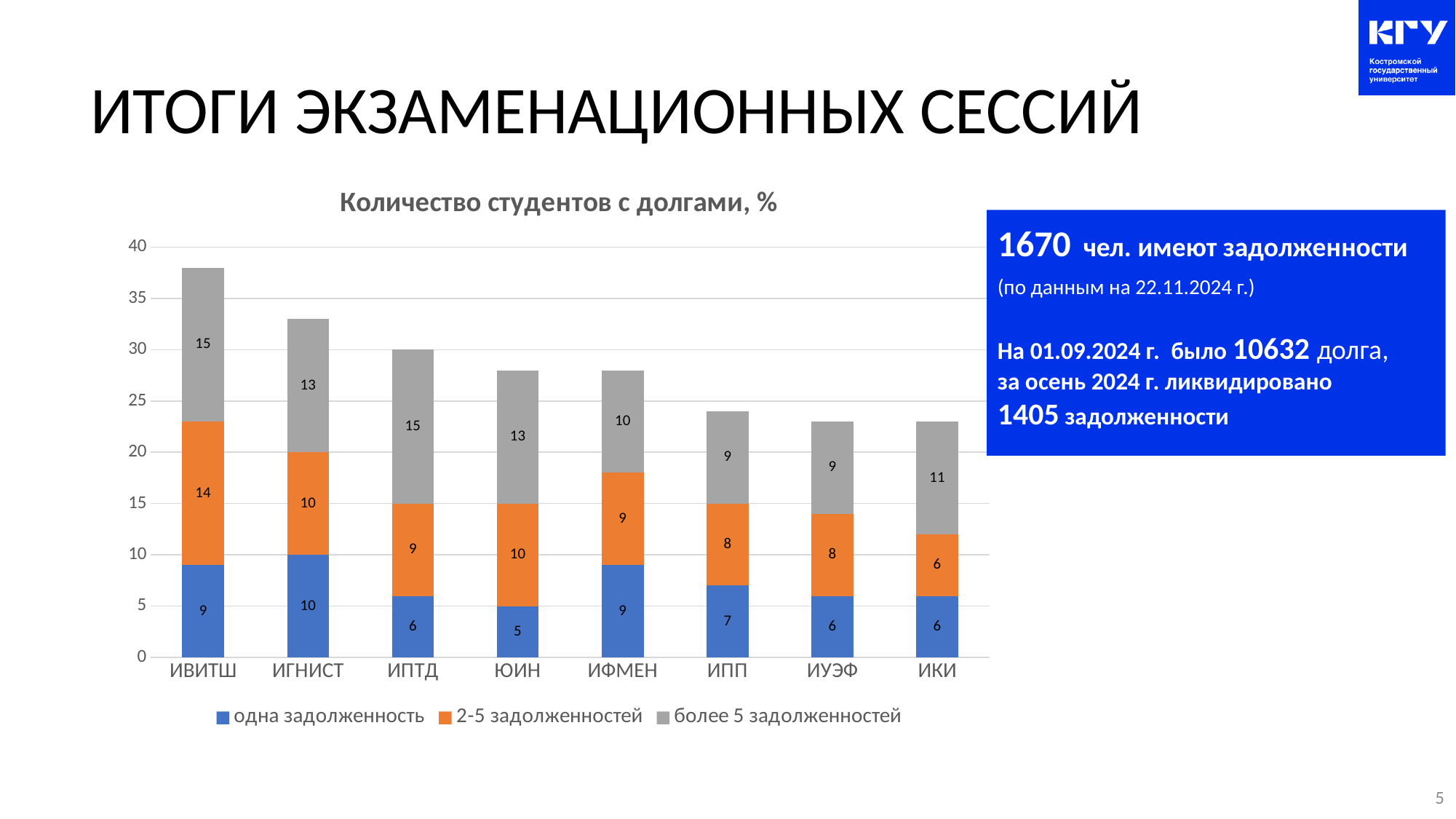
How many series does the chart legend list? 3 What type of chart is shown on the slide? stacked bar chart What is the difference between the 'более 5 задолженностей' values for ИПТД and ИФМЕН? 5 What is the value of 'одна задолженность' for ИВИТШ? 9 How many categories (institutes) are shown on the x axis of the chart? 8 What is the value of '2-5 задолженностей' for ЮИН? 10 Which category has the tallest stacked bar overall? ИВИТШ What is the value of 'более 5 задолженностей' for ИКИ? 11 What is the title of the chart? Количество студентов с долгами, % What is the total of the stacked bar for ИГНИСТ? 33 Which category has the lowest value for 'одна задолженность'? ЮИН Which is larger: the '2-5 задолженностей' value for ИВИТШ or for ИКИ? ИВИТШ